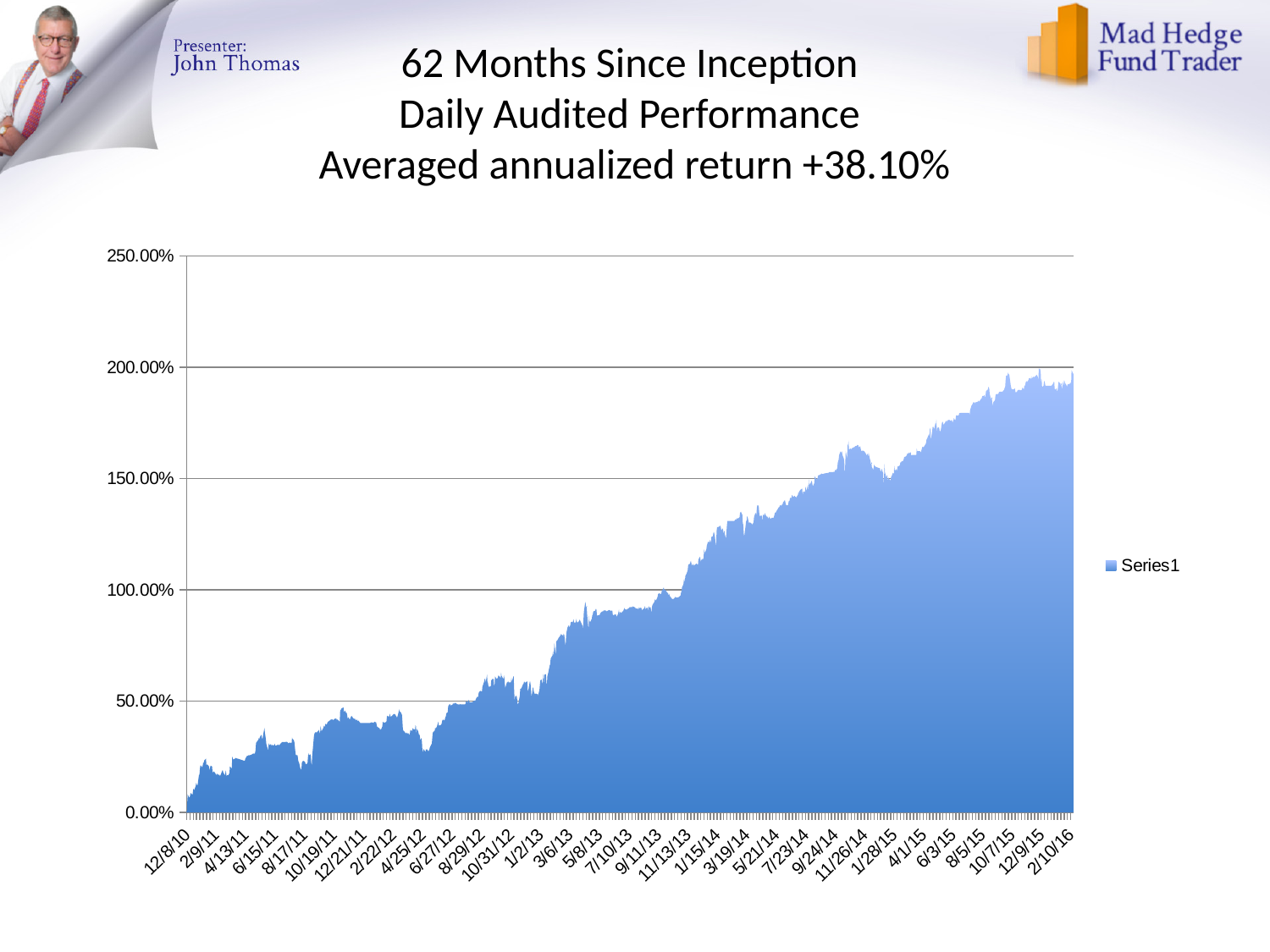
Is the value at 1/15/14 greater or less than 100.00%? greater Is the value at 12/8/10 greater or less than 50.00%? less What is the name of the series shown in the legend? Series1 Is the value at 7/10/13 greater or less than 100.00%? less What kind of chart is shown on the slide? area chart According to the slide title, what is the averaged annualized return? +38.10% Which is larger, the value at 2/10/16 or the value at 12/8/10? 2/10/16 How many series does the legend list? 1 Overall, do the values rise or fall from 12/8/10 to 2/10/16? rise